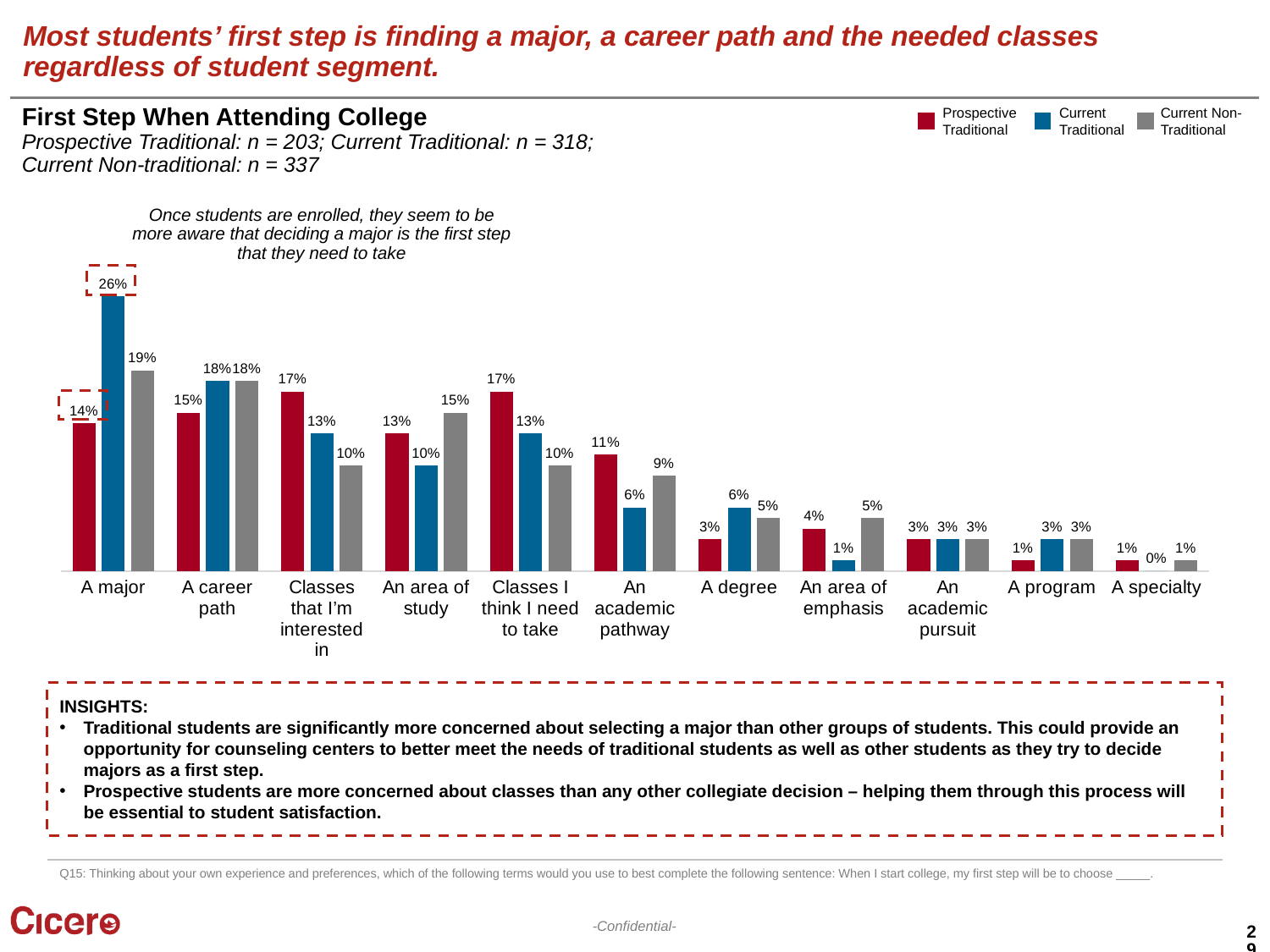
Which category has the lowest Current Traditional value? A specialty What kind of chart is shown on the slide? Bar chart What is the title of the chart? First Step When Attending College What is the Current Traditional value for "A major"? 26% How many categories are shown on the x axis? 11 What is the Current Traditional value for "An area of emphasis"? 1% Which category has the highest Current Traditional value? A major Which is larger for "An academic pathway": the Prospective Traditional value or the Current Non-Traditional value? Prospective Traditional What is the difference between the Current Traditional and Prospective Traditional values for "A major"? 12% What is the Current Non-Traditional value for "An area of study"? 15% What is the Prospective Traditional value for "Classes I think I need to take"? 17% How many series does the legend list? 3